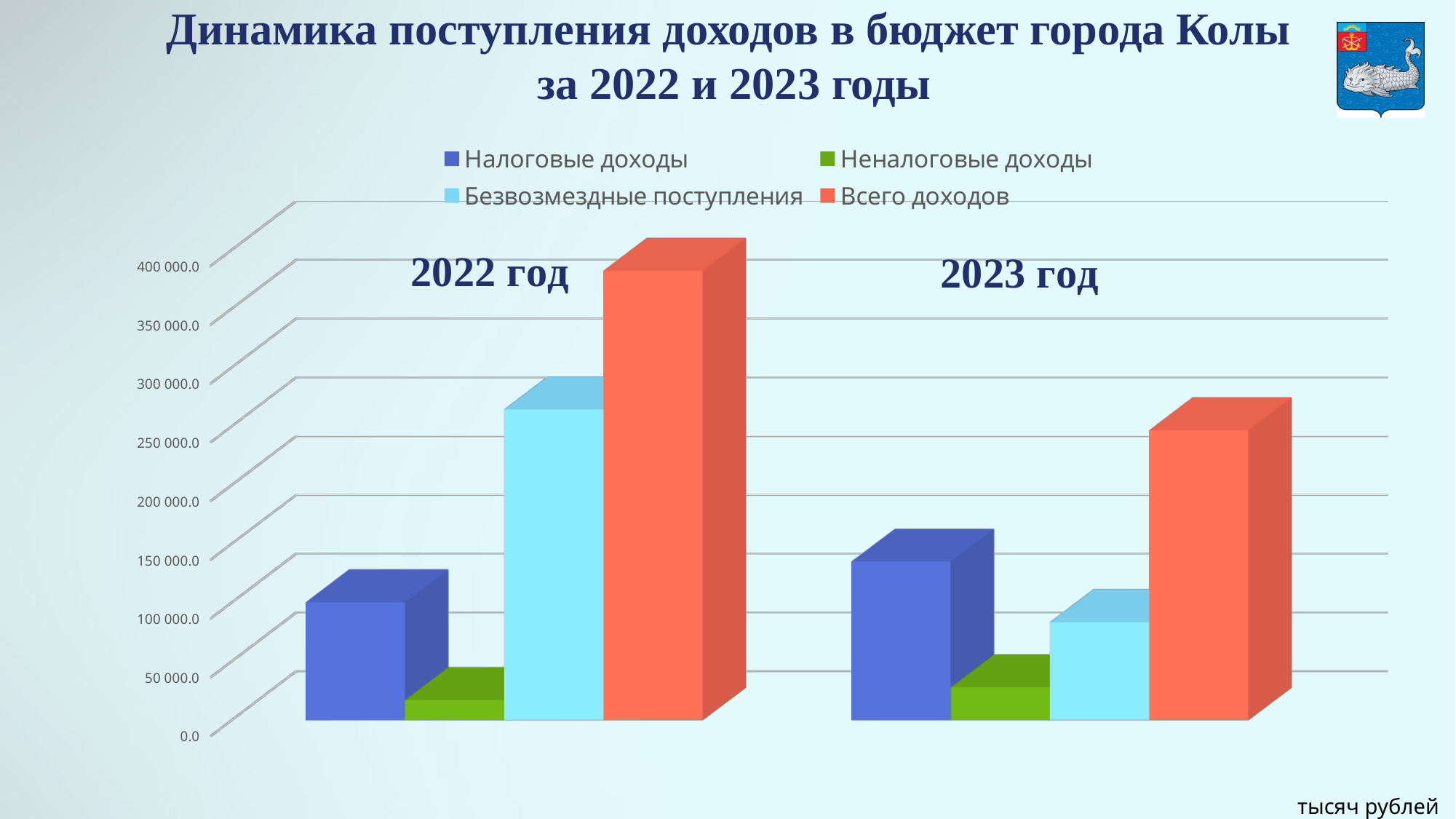
Is the value of Безвозмездные поступления for 2023 год greater or less than 100 000.0? less Does the value of Всего доходов rise or fall from 2022 год to 2023 год? fall Is the value of Всего доходов for 2022 год greater or less than 350 000.0? greater Which series has the lowest bar for 2023 год? Неналоговые доходы Which year has the larger value for Безвозмездные поступления, 2022 год or 2023 год? 2022 год How many series does the legend list? 4 What kind of chart is shown on the slide? bar chart Is the value of Всего доходов for 2023 год greater or less than 300 000.0? less Which series has the highest bar for 2022 год? Всего доходов How many year categories are shown on the x axis? 2 Which series has the lowest bar for 2022 год? Неналоговые доходы